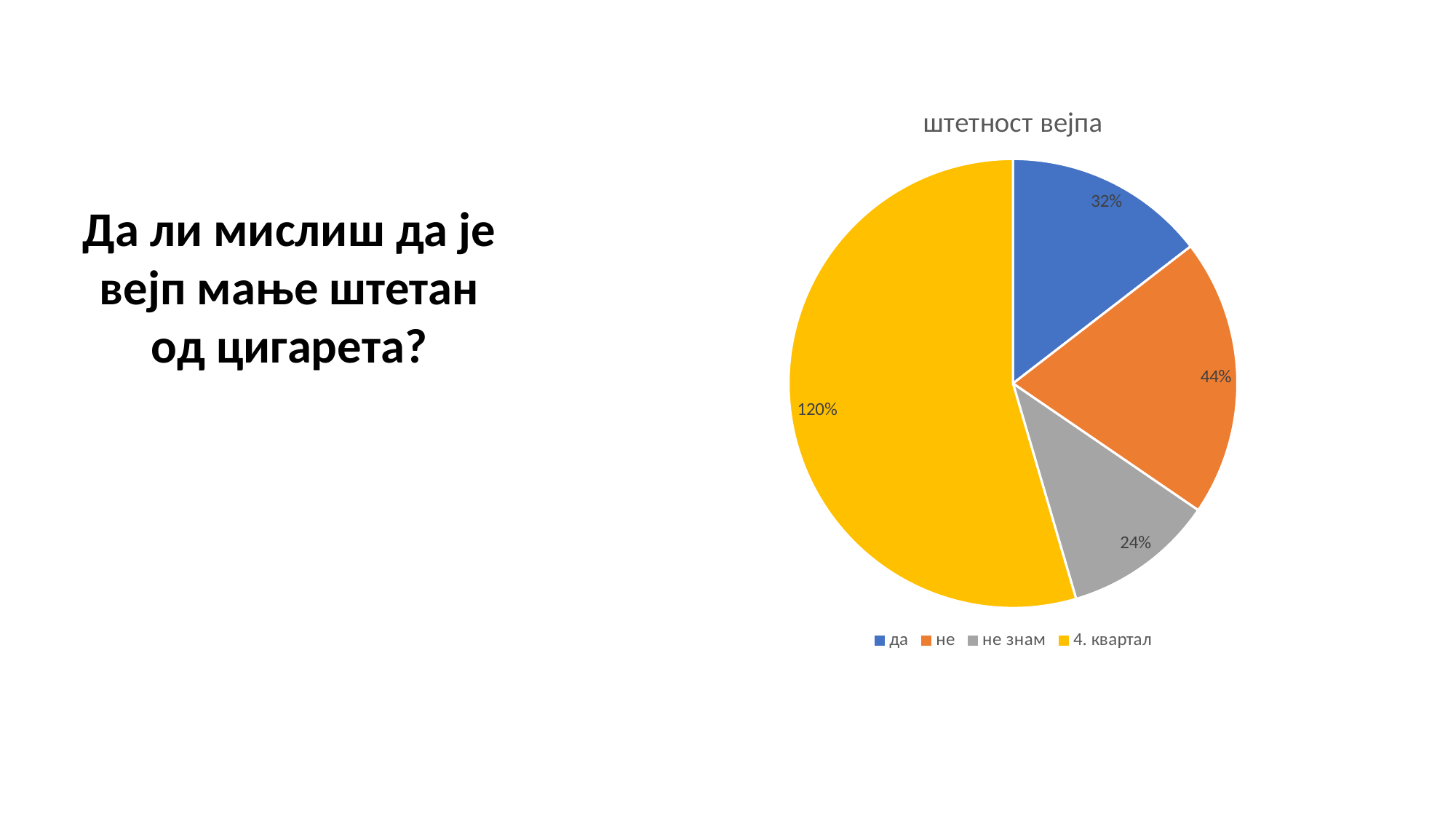
What type of chart is shown on the slide? pie chart What colour is the slice for "не знам"? grey What value is labelled on the slice for "не"? 44% What is the difference between the values for "не" and "да"? 12% How many slices does the pie chart have? 4 What value is labelled on the slice for "да"? 32% Which slice has the smallest value? не знам Which slice has the largest value? 4. квартал Which is larger, the value for "да" or the value for "не"? не What value is labelled on the slice for "не знам"? 24% What is the title of the chart? штетност вејпа What value is labelled on the slice for "4. квартал"? 120%